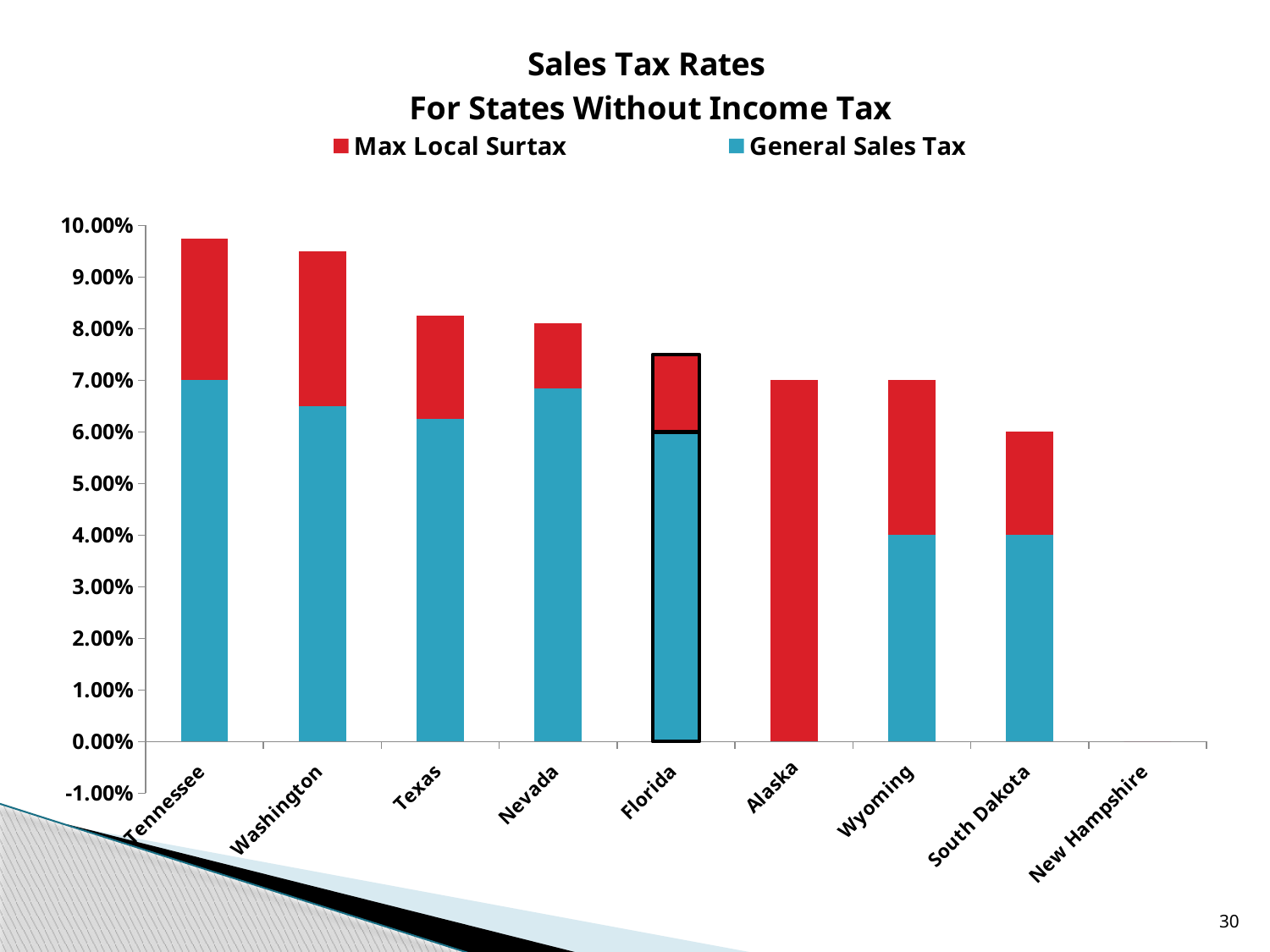
Do the total bar heights generally rise or fall from left to right along the x axis? Fall How many series does the legend list? 2 How many states are shown on the x axis? 9 What is the total stacked value for Alaska? 7.00% Is the total value for Texas greater or less than 8.00%? greater What is the General Sales Tax value for Wyoming? 4.00% What is the difference between the General Sales Tax for Tennessee and for Wyoming? 3.00% What kind of chart is shown on the slide? Stacked bar chart What is the total stacked value for South Dakota? 6.00% What is the General Sales Tax value for Tennessee? 7.00% What is the General Sales Tax value for Florida? 6.00% Which state has the highest total sales tax rate? Tennessee